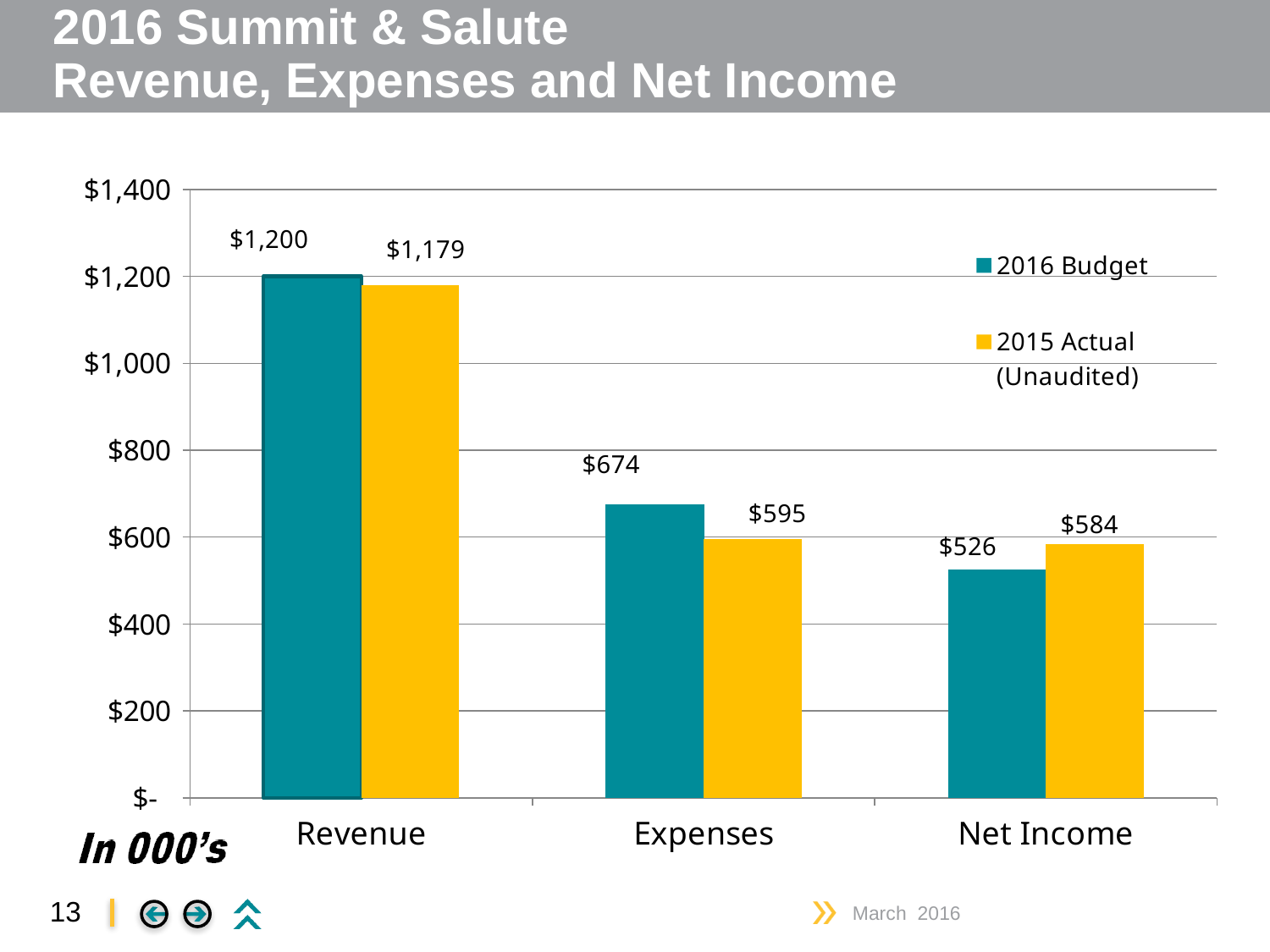
For Net Income, which is larger: the 2016 Budget or the 2015 Actual (Unaudited) value? 2015 Actual (Unaudited) Is the 2016 Budget value for Expenses greater or less than $600? greater What is the 2016 Budget value for Net Income? $526 How many series does the legend list? 2 What is the 2015 Actual (Unaudited) value for Expenses? $595 What unit note appears below the y axis of the chart? In 000's What kind of chart is shown on the slide? Bar chart How many categories are shown on the x axis? 3 Which category has the lowest 2016 Budget value? Net Income What is the difference between the 2016 Budget and 2015 Actual (Unaudited) values for Expenses? $79 Which category has the highest 2015 Actual (Unaudited) value? Revenue What is the 2016 Budget value for Revenue? $1,200